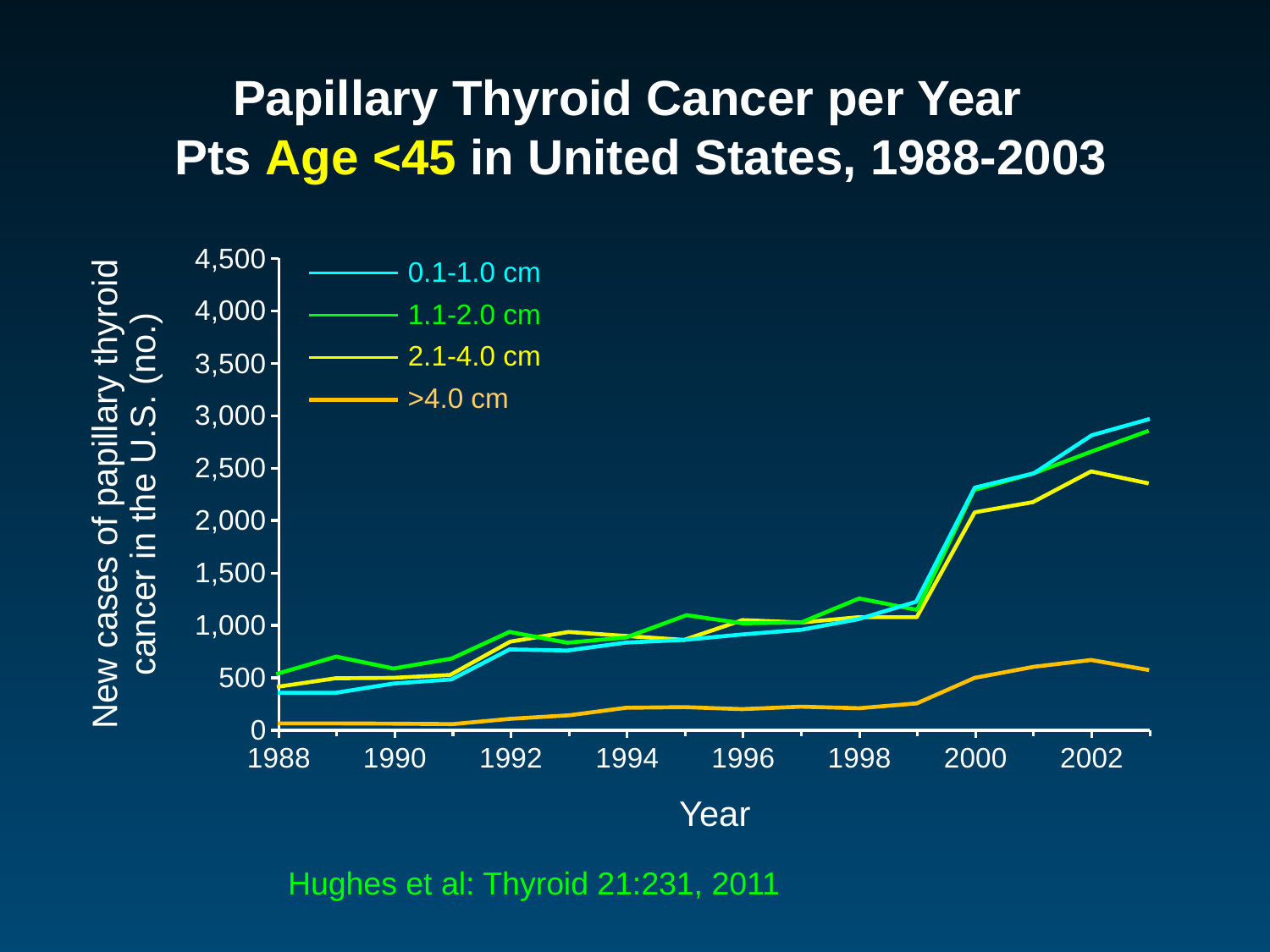
Is the value for the 0.1-1.0 cm series in 2003 greater or less than 2,500? greater How many series does the legend list? 4 Which series has the highest value in 2003? 0.1-1.0 cm Do the values for the 0.1-1.0 cm series generally rise or fall from 1988 to 2003? rise Is the value for the 2.1-4.0 cm series in 2003 greater or less than 2,000? greater How many years are plotted along the x axis? 16 What kind of chart is shown on the slide? line chart What is the label on the x axis of the chart? Year In 2003, which is larger: the value for 0.1-1.0 cm or the value for >4.0 cm? 0.1-1.0 cm Which series has the lowest values across all years? >4.0 cm Is the value for the 0.1-1.0 cm series in 1988 greater or less than 500? less